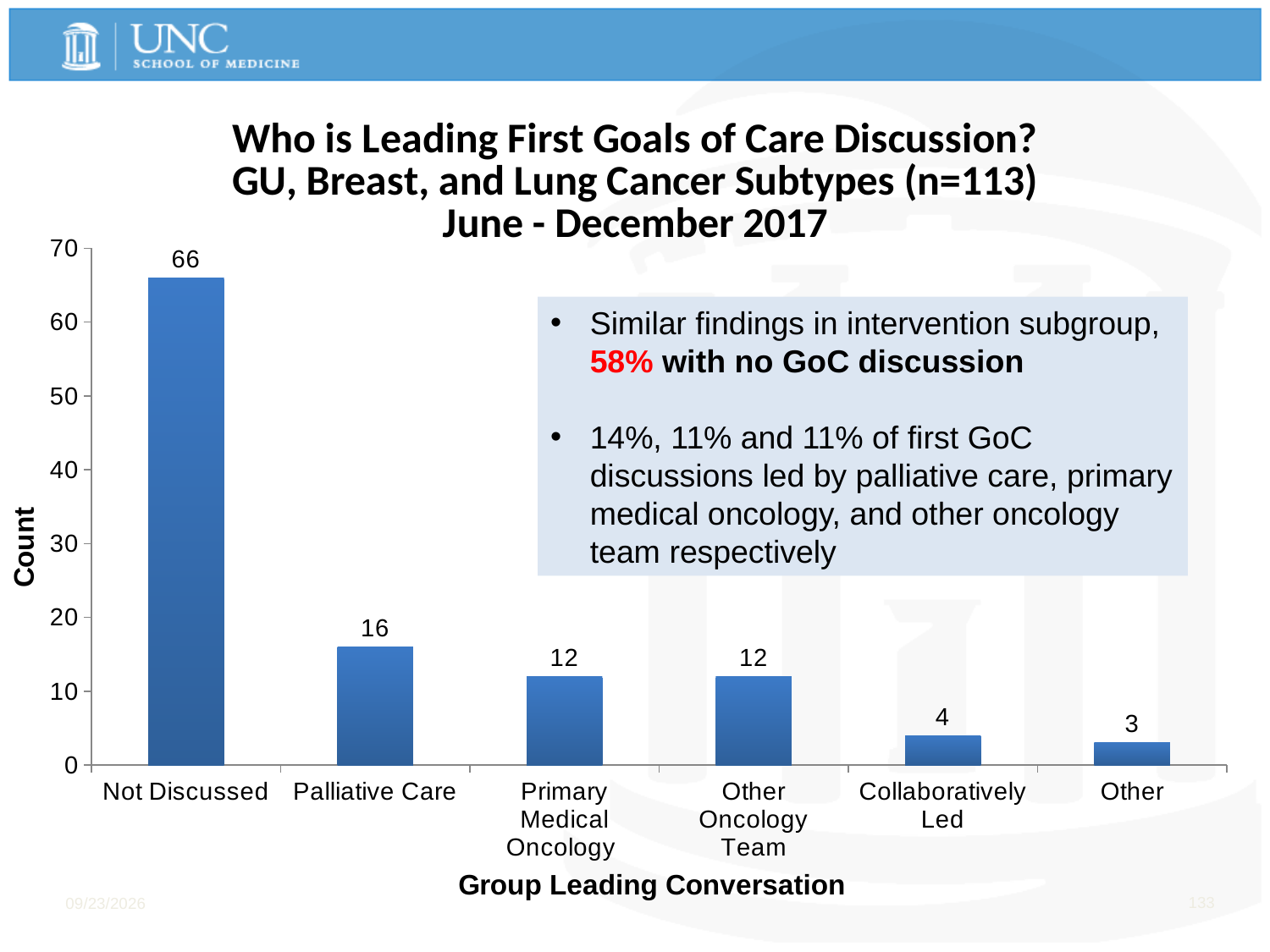
What is the count for Palliative Care? 16 What is the label of the x axis? Group Leading Conversation How many groups are shown on the x axis? 6 What is the difference between the counts for Not Discussed and Palliative Care? 50 Which has a larger count, Palliative Care or Primary Medical Oncology? Palliative Care What is the count for Collaboratively Led? 4 Which group has the highest count? Not Discussed What kind of chart is shown on the slide? Bar chart What is the label of the y axis? Count Which group has the lowest count? Other Is the value for Not Discussed greater or less than 60? greater What is the count for Not Discussed? 66